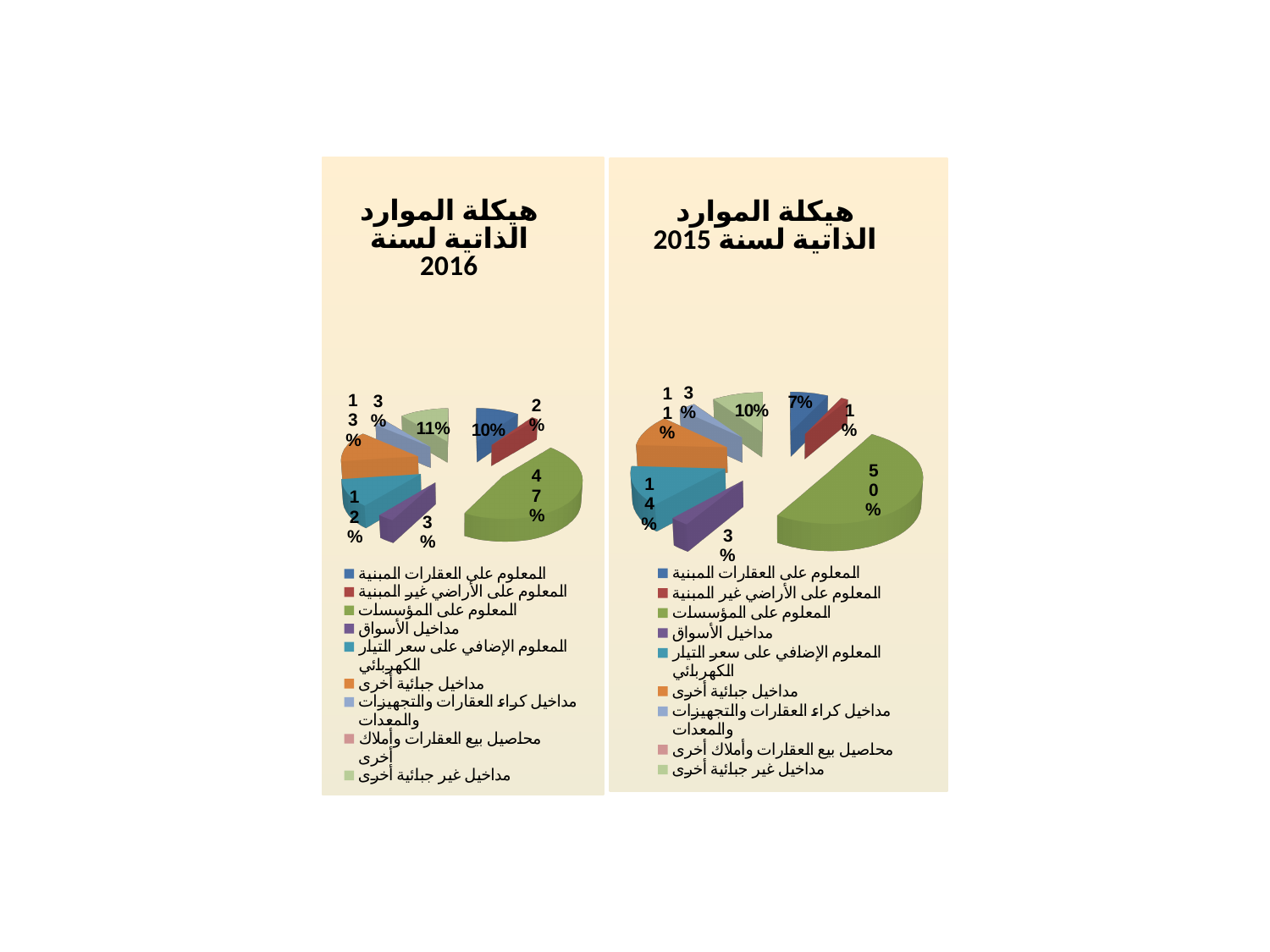
In the chart هيكلة الموارد الذاتية لسنة 2015, what percentage is shown for المعلوم الإضافي على سعر التيار الكهربائي? 14% In the chart هيكلة الموارد الذاتية لسنة 2016, which category has the largest share? المعلوم على المؤسسات In the chart هيكلة الموارد الذاتية لسنة 2015, which labelled category has the smallest share? المعلوم على الأراضي غير المبنية In the chart هيكلة الموارد الذاتية لسنة 2016, what percentage is shown for المعلوم على العقارات المبنية? 10% In the chart هيكلة الموارد الذاتية لسنة 2015, what is the combined share of المعلوم على العقارات المبنية and المعلوم على الأراضي غير المبنية? 8% What type of chart is used on the slide for هيكلة الموارد الذاتية لسنة 2015? Pie chart What is the title of the chart on the right side of the slide? هيكلة الموارد الذاتية لسنة 2015 In the chart هيكلة الموارد الذاتية لسنة 2016, which is larger: the share of مداخيل الأسواق or the share of مداخيل غير جبائية أخرى? مداخيل غير جبائية أخرى What is the difference between the share of المعلوم على المؤسسات in the 2015 chart and in the 2016 chart? 3% How many entries does the legend of the chart هيكلة الموارد الذاتية لسنة 2016 list? 9 In the chart هيكلة الموارد الذاتية لسنة 2015, what percentage is shown for المعلوم على المؤسسات? 50% In the chart هيكلة الموارد الذاتية لسنة 2016, what percentage is shown for مداخيل جبائية أخرى? 13%